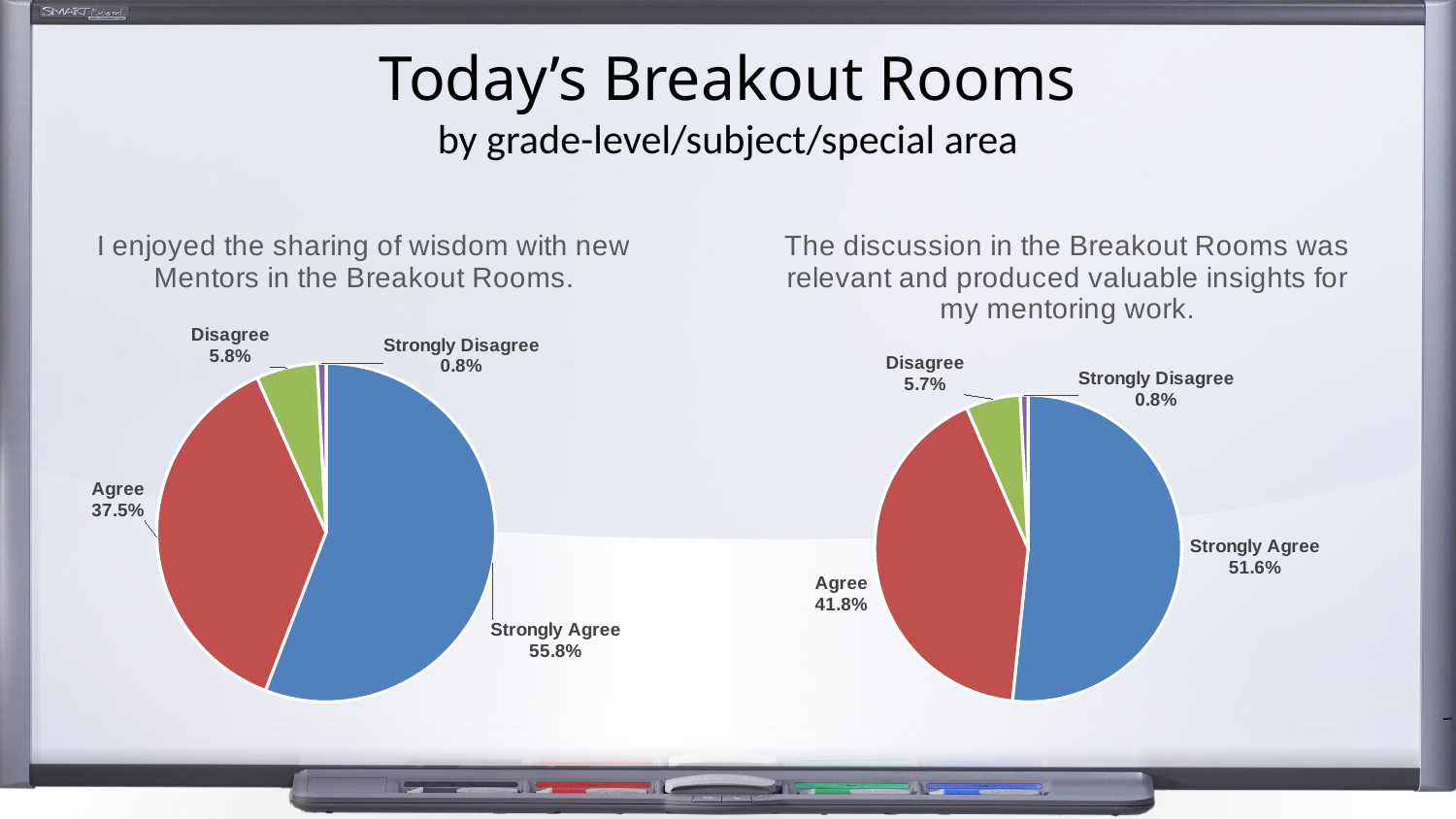
What colour is the Agree slice in the left pie chart? Red In the left pie chart ('I enjoyed the sharing of wisdom...'), what share is labelled for Agree? 37.5% In the left pie chart ('I enjoyed the sharing of wisdom...'), what is the difference between the Strongly Agree and Agree shares? 18.3% What type of chart is used on the right side of the slide? Pie chart Which is larger: the Agree share in the left pie chart or the Agree share in the right pie chart? The right pie chart (41.8%) In the left pie chart ('I enjoyed the sharing of wisdom with new Mentors in the Breakout Rooms.'), what share is labelled for Strongly Agree? 55.8% In the right pie chart ('The discussion in the Breakout Rooms was relevant...'), what share is labelled for Disagree? 5.7% In the right pie chart ('The discussion in the Breakout Rooms was relevant...'), what is the difference between the Strongly Agree and Agree shares? 9.8% In the right pie chart ('The discussion in the Breakout Rooms was relevant...'), which category has the smallest slice? Strongly Disagree In the right pie chart ('The discussion in the Breakout Rooms was relevant...'), what share is labelled for Strongly Agree? 51.6% In the left pie chart ('I enjoyed the sharing of wisdom...'), which category has the largest slice? Strongly Agree How many categories does the left pie chart ('I enjoyed the sharing of wisdom...') show? 4